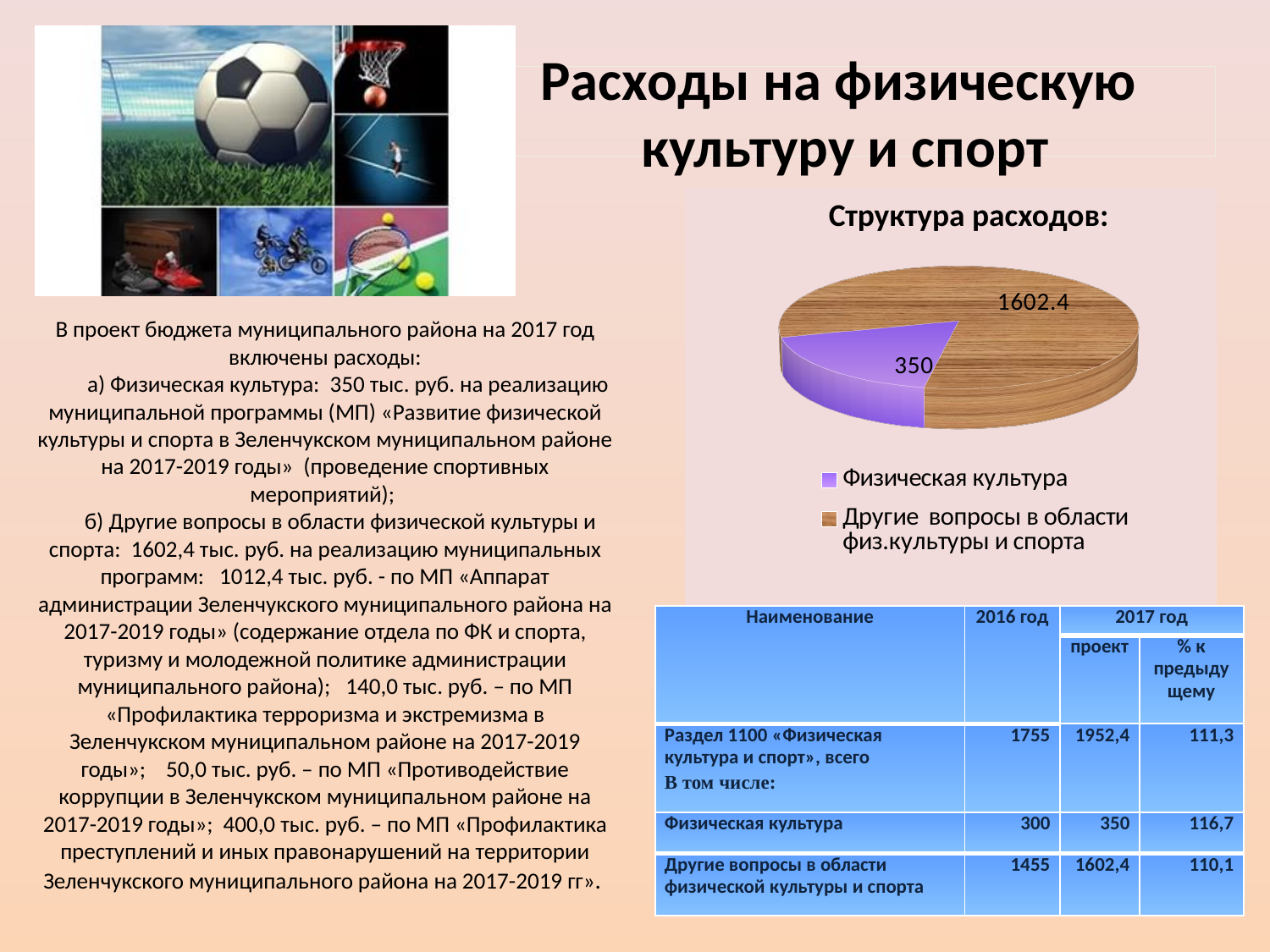
In the pie chart, what is the value for "Другие вопросы в области физ.культуры и спорта"? 1602.4 In the pie chart, which is larger: "Физическая культура" or "Другие вопросы в области физ.культуры и спорта"? Другие вопросы в области физ.культуры и спорта What kind of chart is shown under the heading "Структура расходов:"? Pie chart How many slices does the pie chart have? 2 How many entries does the legend of the pie chart list? 2 In the pie chart, what is the value for "Физическая культура"? 350 What is the total of the two values shown in the pie chart? 1952.4 What is the difference between the two values shown in the pie chart? 1252.4 Which slice of the pie chart is the smallest? Физическая культура What colour is the "Физическая культура" slice in the pie chart? Purple Which slice of the pie chart is the largest? Другие вопросы в области физ.культуры и спорта